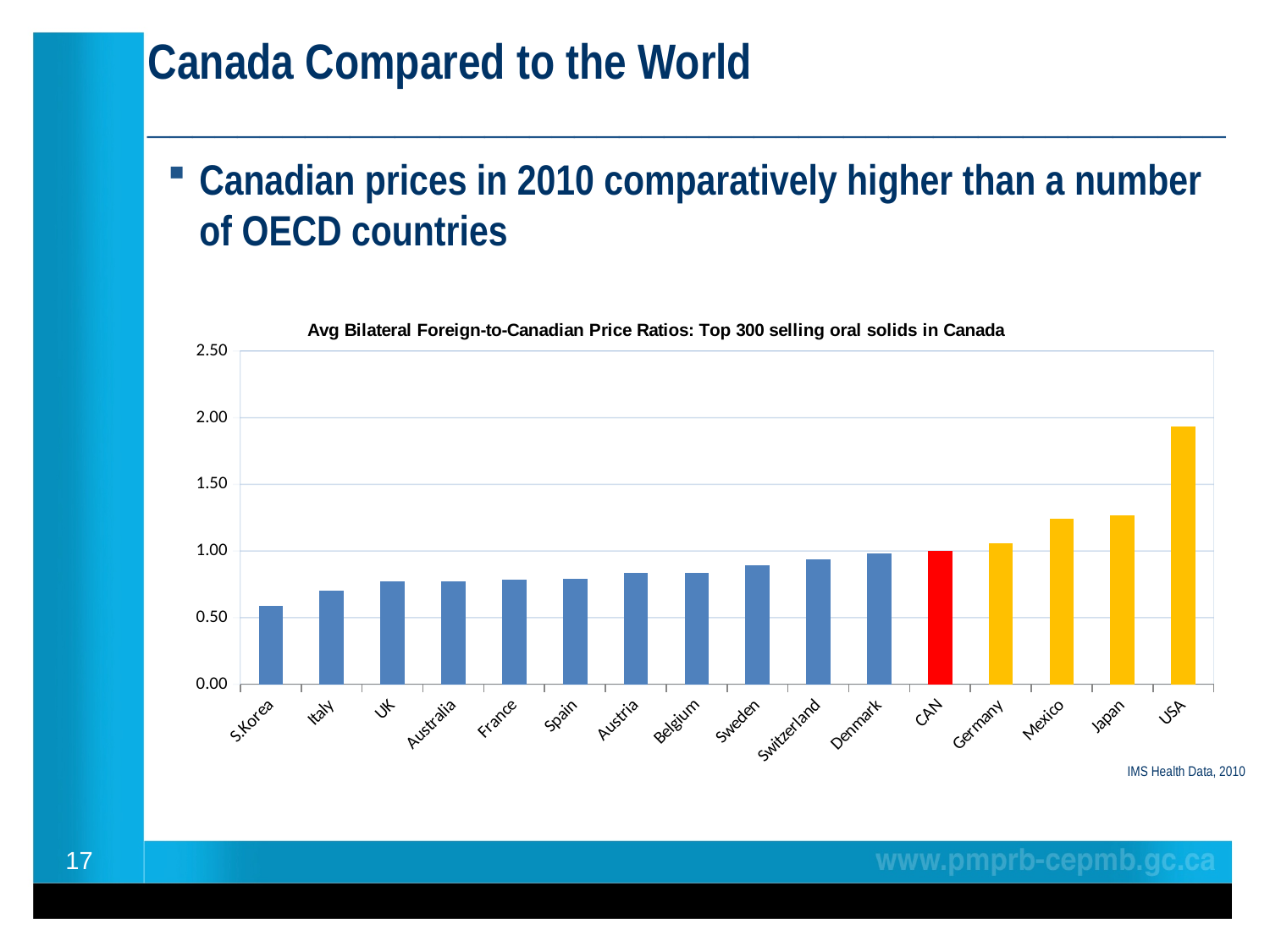
Which country has the highest average bilateral foreign-to-Canadian price ratio? USA Do the values generally rise or fall from left to right along the x axis? rise Is the value for Italy greater or less than 1.00? less What kind of chart is shown on the slide? bar chart What colour is the bar for CAN? red Is the value for USA greater or less than 1.50? greater How many countries are shown on the x axis of the chart? 16 Which has the larger price ratio, USA or Japan? USA Which country has the lowest average bilateral foreign-to-Canadian price ratio? S.Korea Is the value for Mexico greater or less than 1.00? greater What is the price ratio value for CAN? 1.00